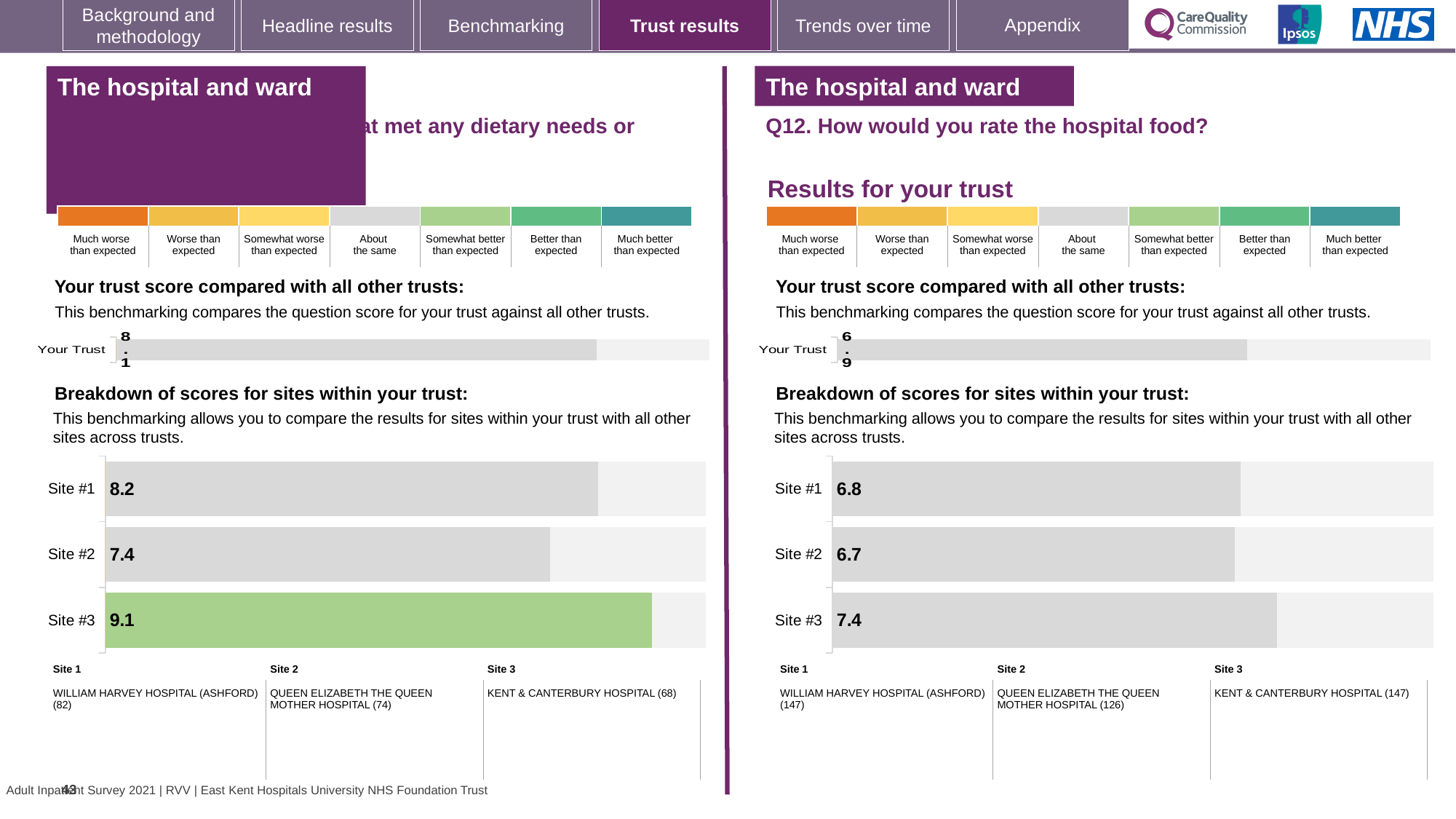
How many sites are shown in the right-hand site breakdown chart for Q12? 3 On the right-hand chart for Q12 (How would you rate the hospital food?), which site has the highest score? Site #3 What type of chart is used for the site breakdown on the right-hand side for Q12? Bar chart On the left-hand site breakdown chart, which site has the lowest score? Site #2 On the right-hand 'Your trust score compared with all other trusts' chart for Q12, what is the score shown for Your Trust? 6.9 On the left-hand 'Your trust score compared with all other trusts' chart, what is the score shown for Your Trust? 8.1 On the left-hand site breakdown chart, what is the difference between the Site #3 score and the Site #1 score? 0.9 On the right-hand chart for Q12 (How would you rate the hospital food?), what is the score for Site #3? 7.4 On the left-hand site breakdown chart, what is the score for Site #3? 9.1 On the right-hand chart for Q12 (How would you rate the hospital food?), what is the difference between the Site #3 score and the Site #2 score? 0.7 On the left-hand site breakdown chart, what is the score for Site #2? 7.4 On the right-hand chart for Q12 (How would you rate the hospital food?), what is the score for Site #1? 6.8